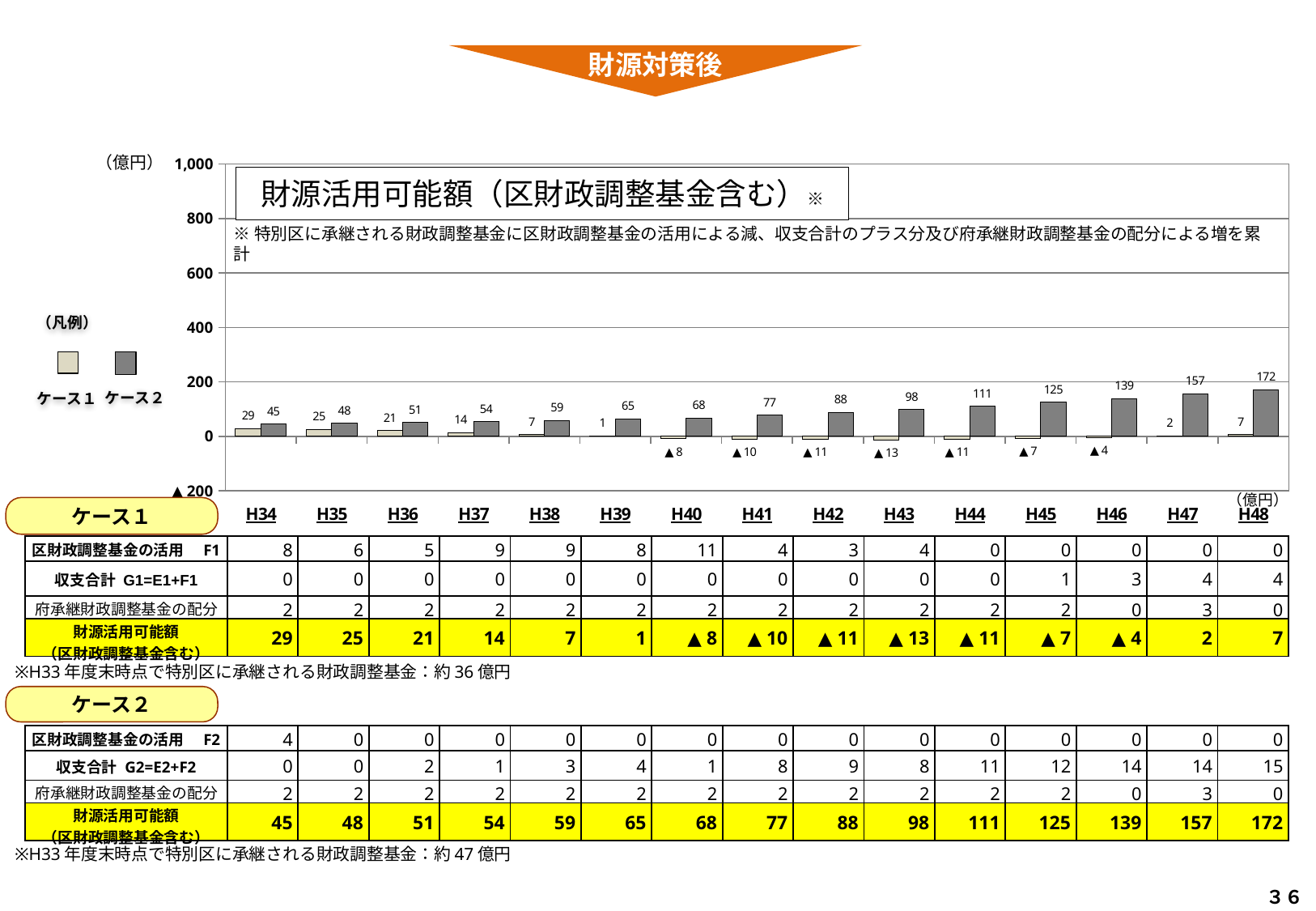
What is the value for ケース2 in H48? 172 Do the values for ケース2 rise or fall from H34 to H48? rise Is the value for ケース2 in H44 greater or less than 200? less What is the value for ケース1 in H34? 29 In which year does ケース1 have its lowest value? H43 How many years are shown on the x axis of the chart? 15 What kind of chart is shown on the slide? bar chart What is the difference between ケース2 and ケース1 in H48? 165 In H40, which is larger, ケース1 or ケース2? ケース2 What is the value for ケース1 in H43? ▲13 How many series does the legend list? 2 In which year does ケース2 reach its highest value? H48